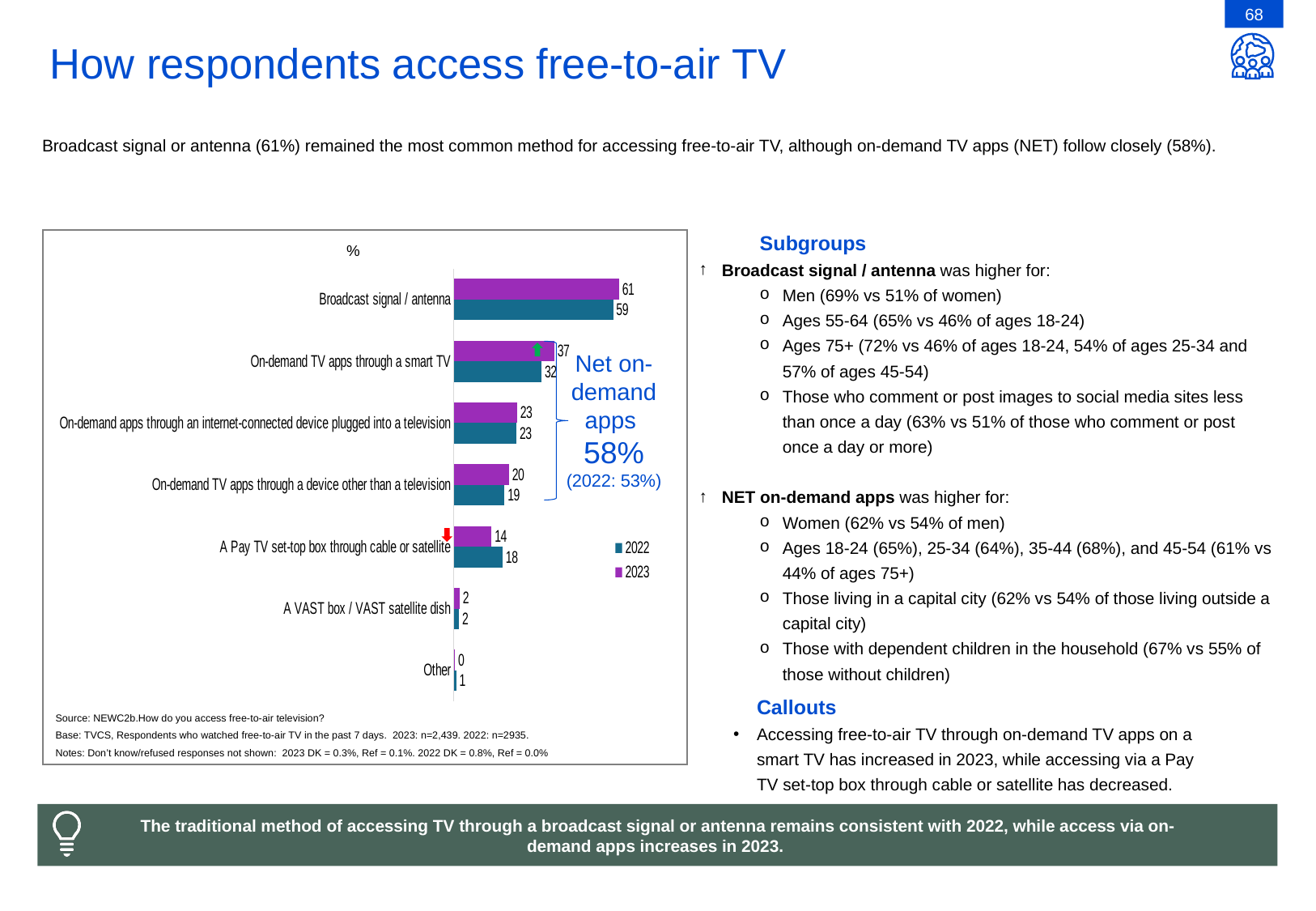
What is the difference between the 2023 and 2022 values for On-demand TV apps through a smart TV? 5 What is the 2023 value for Broadcast signal / antenna? 61 What is the 2023 value for A Pay TV set-top box through cable or satellite? 14 Which is larger for A Pay TV set-top box through cable or satellite: the 2022 value or the 2023 value? 2022 What is the difference between the 2022 and 2023 values for A Pay TV set-top box through cable or satellite? 4 How many series does the legend list? 2 What is the 2022 value for On-demand TV apps through a device other than a television? 19 Which category has the highest 2023 value? Broadcast signal / antenna Which category has the lowest 2023 value? Other How many categories are shown in the chart? 7 What kind of chart is shown on the slide? Bar chart What is the 2022 value for On-demand TV apps through a smart TV? 32